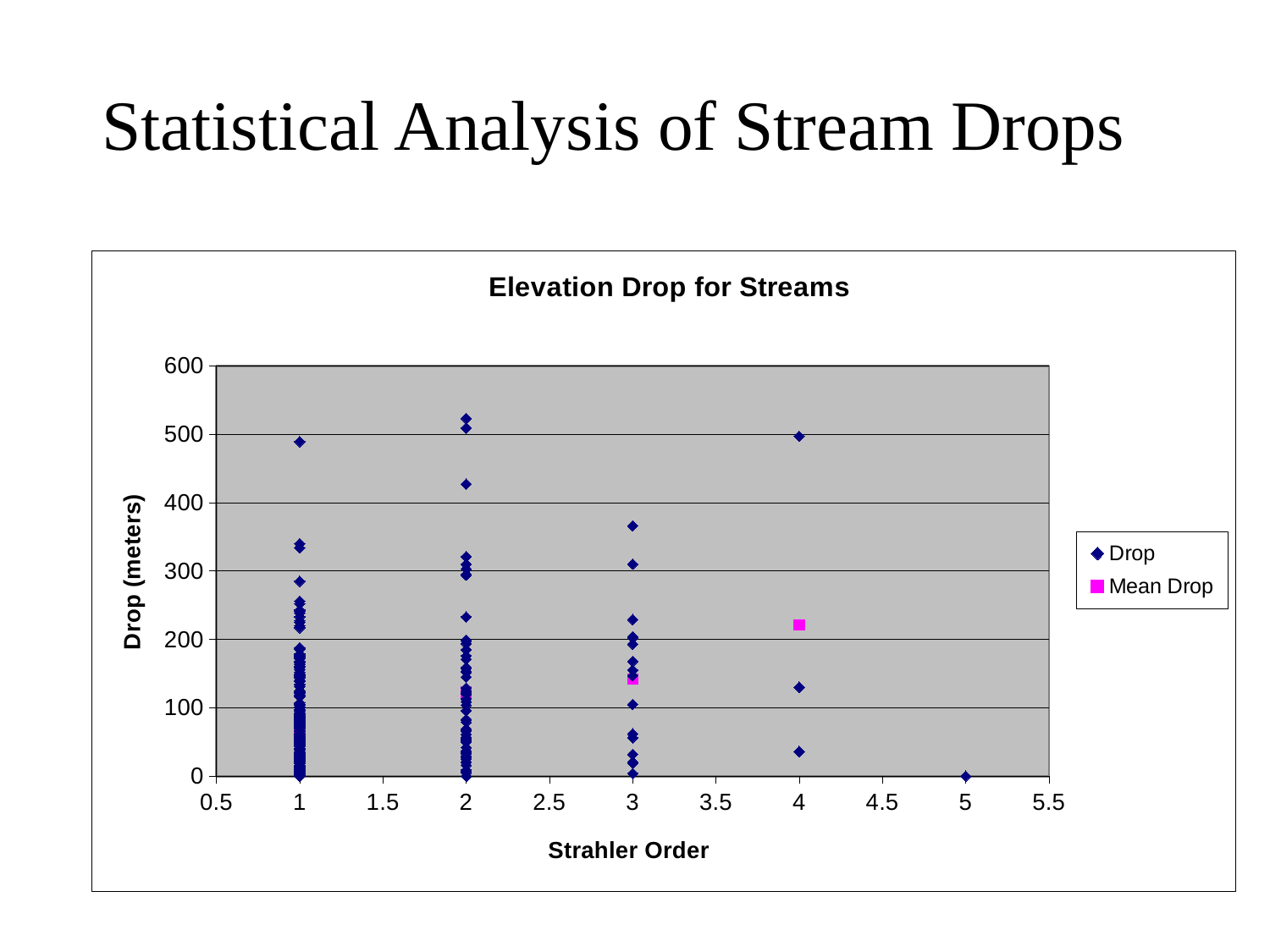
Is the Mean Drop value at Strahler Order 4 greater or less than 200? greater Is the Mean Drop value at Strahler Order 3 greater or less than 200? less What is the title of the chart? Elevation Drop for Streams What kind of chart is shown on the slide? Scatter chart How many series does the legend of the chart list? 2 What is the label of the y axis of the chart? Drop (meters) Which Strahler Order has the highest Drop value plotted on the chart? 2 How many distinct Strahler Order values have Drop points plotted on the chart? 5 Is the highest Drop value at Strahler Order 3 greater or less than 400? less